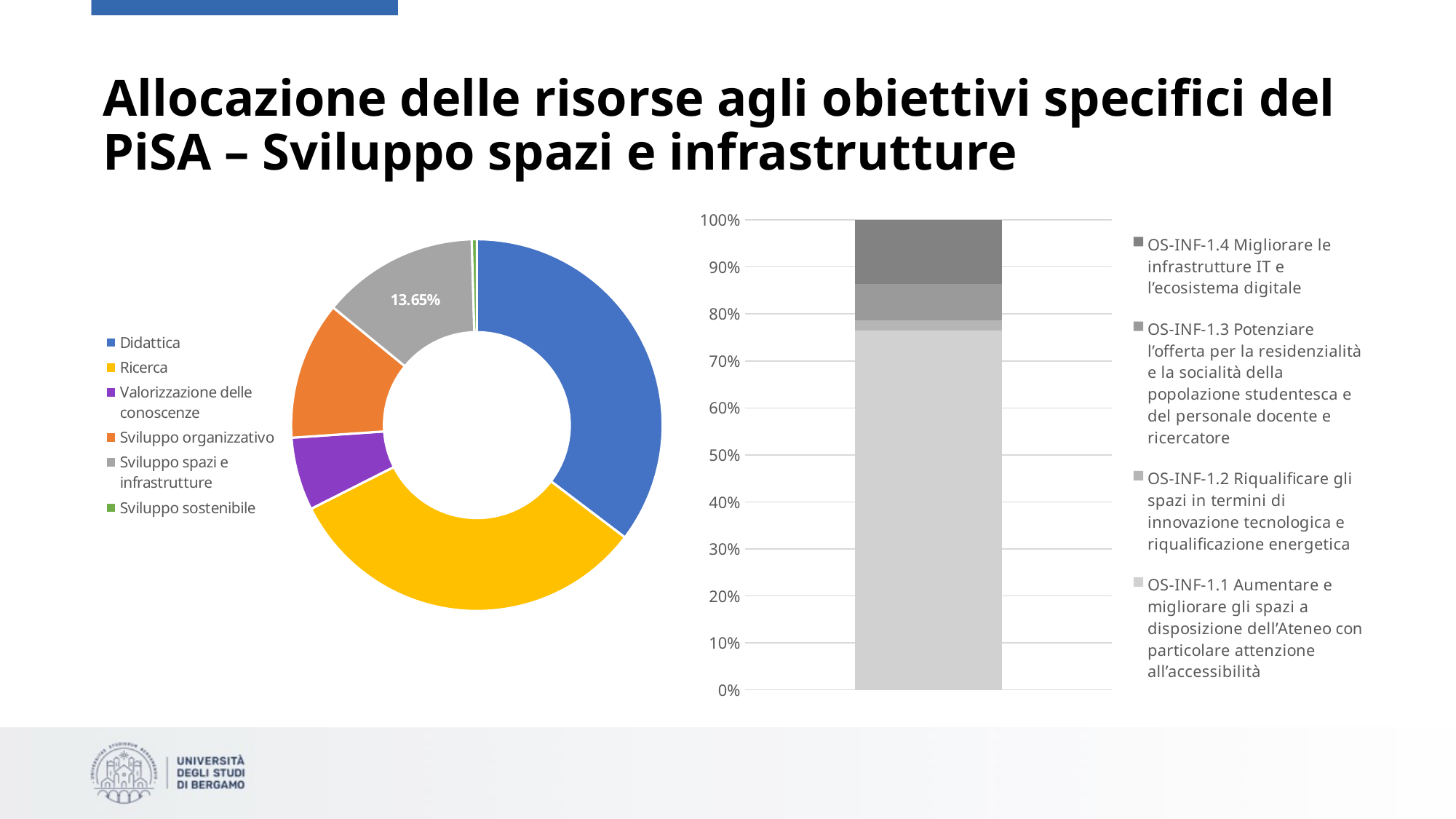
In the stacked bar chart on the right, how many series does the legend list? 4 In the stacked bar chart on the right, which series takes the largest share of the bar? OS-INF-1.1 Aumentare e migliorare gli spazi a disposizione dell'Ateneo con particolare attenzione all'accessibilità In the donut chart on the left, what percentage is shown for Sviluppo spazi e infrastrutture? 13.65% What kind of chart is the chart on the right of the slide? Stacked bar chart In the stacked bar chart on the right, which series takes the smallest share of the bar? OS-INF-1.2 Riqualificare gli spazi in termini di innovazione tecnologica e riqualificazione energetica In the donut chart on the left, how many categories does the legend list? 6 In the stacked bar chart on the right, is the share for OS-INF-1.1 greater or less than 70%? greater In the stacked bar chart on the right, is the share for OS-INF-1.4 greater or less than 20%? less In the donut chart on the left, which slice is larger: Sviluppo organizzativo or Valorizzazione delle conoscenze? Sviluppo organizzativo In the donut chart on the left, which category has the smallest slice? Sviluppo sostenibile What kind of chart is the chart on the left of the slide? Donut (pie) chart In the donut chart on the left, which colour represents Didattica? Blue